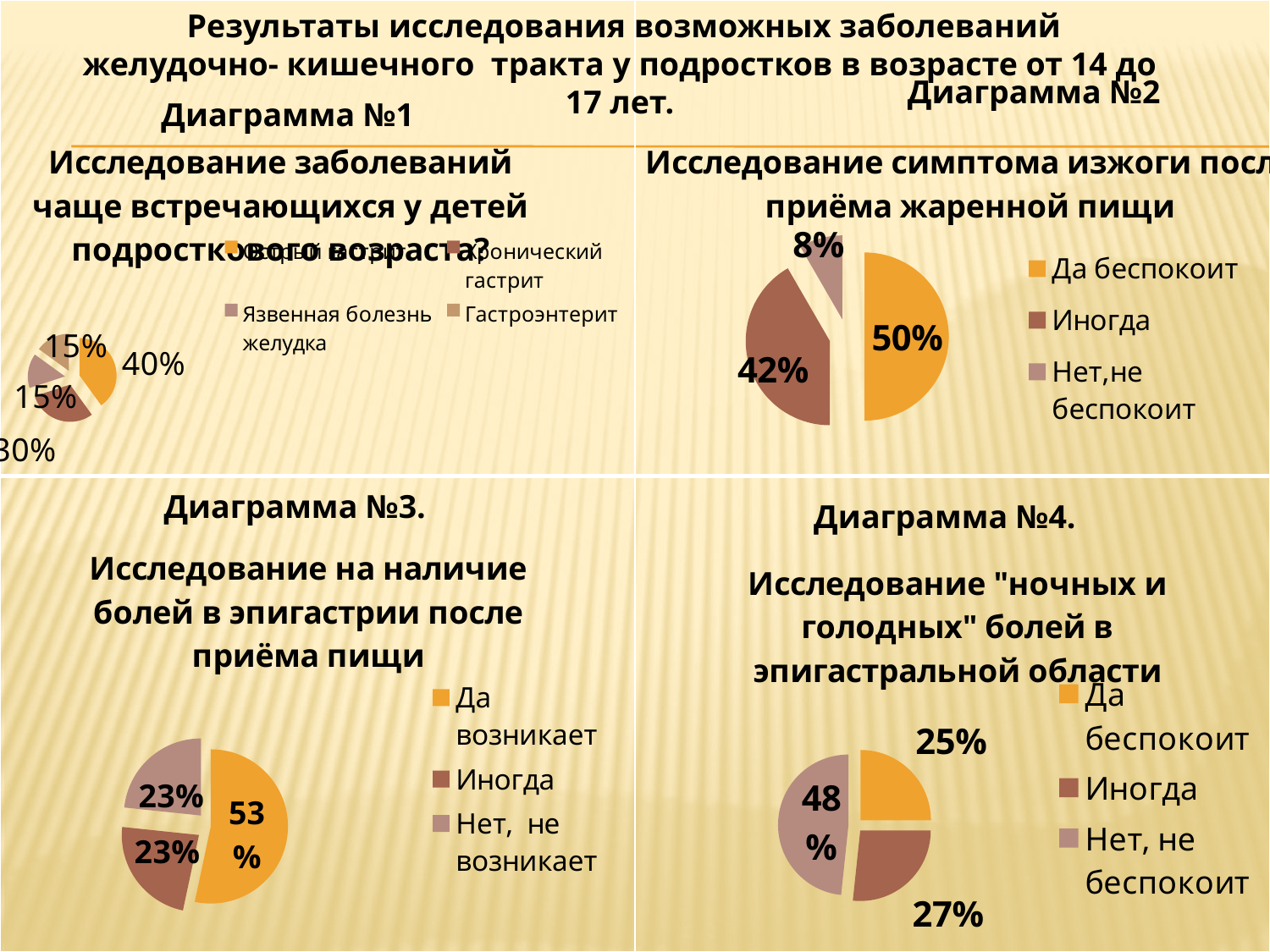
In Диаграмма №1, what is the value of the largest slice? 40% How many categories does the legend of Диаграмма №1 list? 4 In Диаграмма №2, which category has the largest share? Да беспокоит In Диаграмма №3, what percentage is shown for "Да возникает"? 53% In Диаграмма №3, which category has the largest share? Да возникает What type of chart is Диаграмма №3? Pie chart In Диаграмма №2, what is the difference in percentage points between "Да беспокоит" and "Иногда"? 8 In Диаграмма №2, what percentage is shown for "Да беспокоит"? 50% In Диаграмма №2, what percentage is shown for "Нет,не беспокоит"? 8% In Диаграмма №4, which is larger: "Иногда" or "Да беспокоит"? Иногда In Диаграмма №4, what percentage is shown for "Нет, не беспокоит"? 48% In Диаграмма №4, which category has the smallest share? Да беспокоит